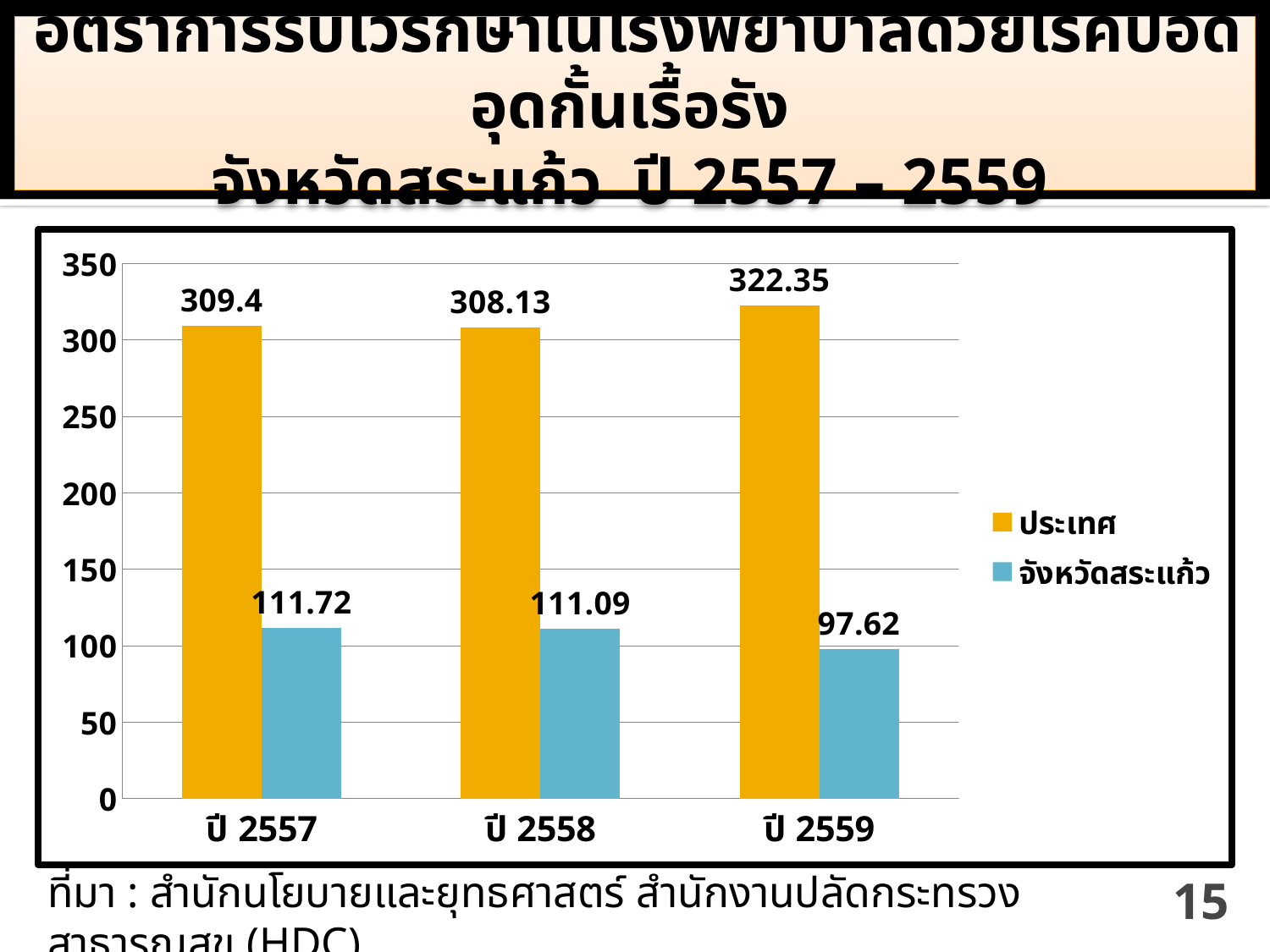
Which is larger in ปี 2557: the value for ประเทศ or for จังหวัดสระแก้ว? ประเทศ What is the value for จังหวัดสระแก้ว in ปี 2558? 111.09 How many series does the legend list? 2 What is the value for ประเทศ in ปี 2557? 309.4 What is the difference between the ประเทศ and จังหวัดสระแก้ว values in ปี 2559? 224.73 Does the value for จังหวัดสระแก้ว rise or fall from ปี 2557 to ปี 2559? fall What is the value for จังหวัดสระแก้ว in ปี 2559? 97.62 In which year is the value for ประเทศ highest? ปี 2559 How many years are shown on the x axis? 3 What is the value for ประเทศ in ปี 2558? 308.13 In which year is the value for จังหวัดสระแก้ว lowest? ปี 2559 What kind of chart is shown on the slide? bar chart